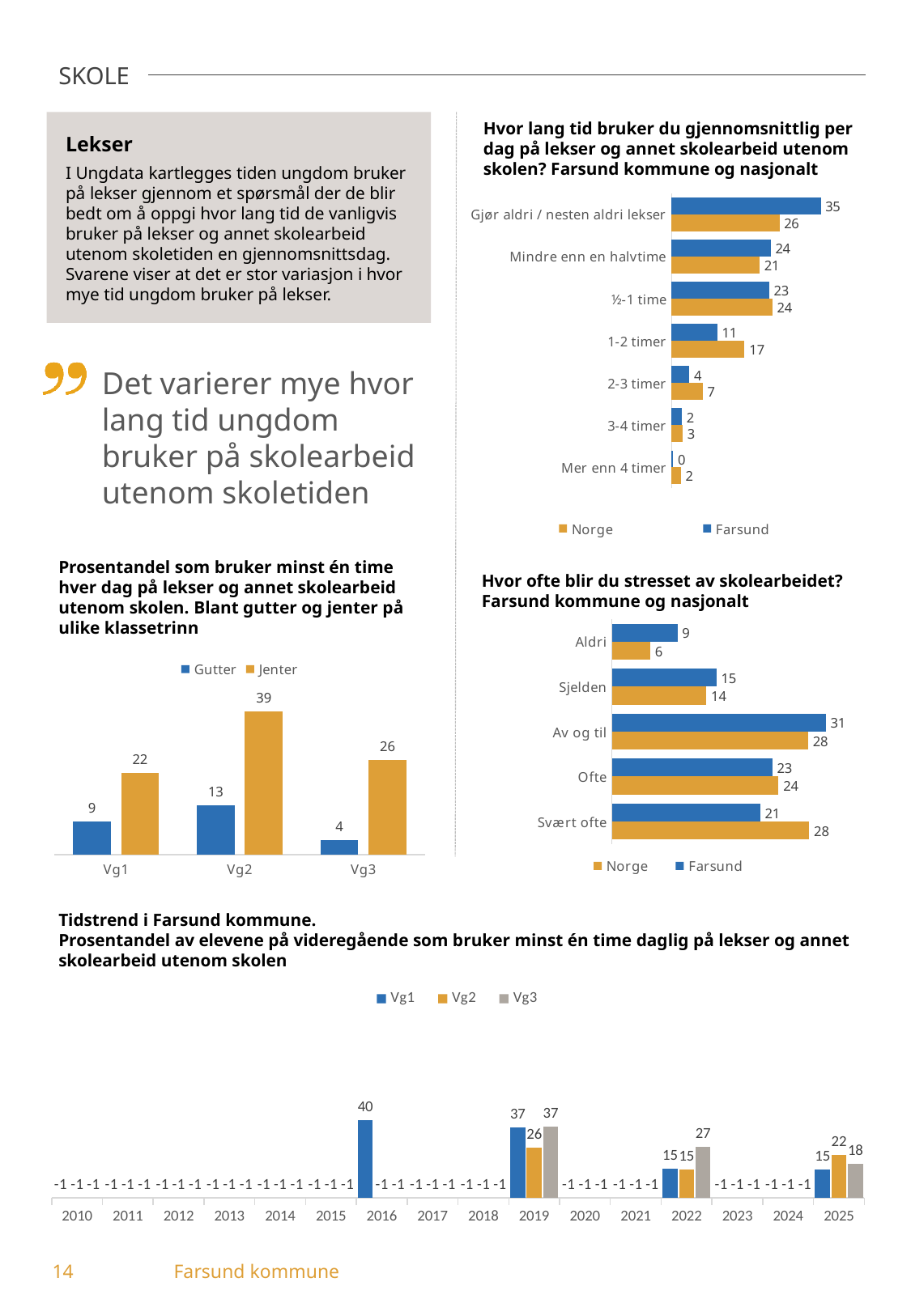
In the chart 'Prosentandel som bruker minst én time hver dag på lekser og annet skolearbeid utenom skolen', what is the value for Gutter in Vg3? 4 In the chart 'Hvor ofte blir du stresset av skolearbeidet?', which category has the highest value for Farsund? Av og til In the chart 'Hvor lang tid bruker du gjennomsnittlig per dag på lekser og annet skolearbeid utenom skolen?', what is the difference between Norge and Farsund for '1-2 timer'? 6 In the chart 'Tidstrend i Farsund kommune', what is the value for Vg1 in 2016? 40 In the chart 'Prosentandel som bruker minst én time hver dag på lekser og annet skolearbeid utenom skolen', what kind of chart is it? Bar chart In the chart 'Hvor ofte blir du stresset av skolearbeidet?', what is the value for Norge for 'Svært ofte'? 28 In the chart 'Tidstrend i Farsund kommune', what is the value for Vg3 in 2022? 27 In the chart 'Tidstrend i Farsund kommune', how many series does the legend list? 3 In the chart 'Prosentandel som bruker minst én time hver dag på lekser og annet skolearbeid utenom skolen', which class level has the highest value for Jenter? Vg2 In the chart 'Hvor lang tid bruker du gjennomsnittlig per dag på lekser og annet skolearbeid utenom skolen?', how many categories are shown? 7 In the chart 'Hvor ofte blir du stresset av skolearbeidet?', which is larger for 'Aldri': Farsund or Norge? Farsund In the chart 'Hvor lang tid bruker du gjennomsnittlig per dag på lekser og annet skolearbeid utenom skolen?', what is the value for Farsund for 'Gjør aldri / nesten aldri lekser'? 35